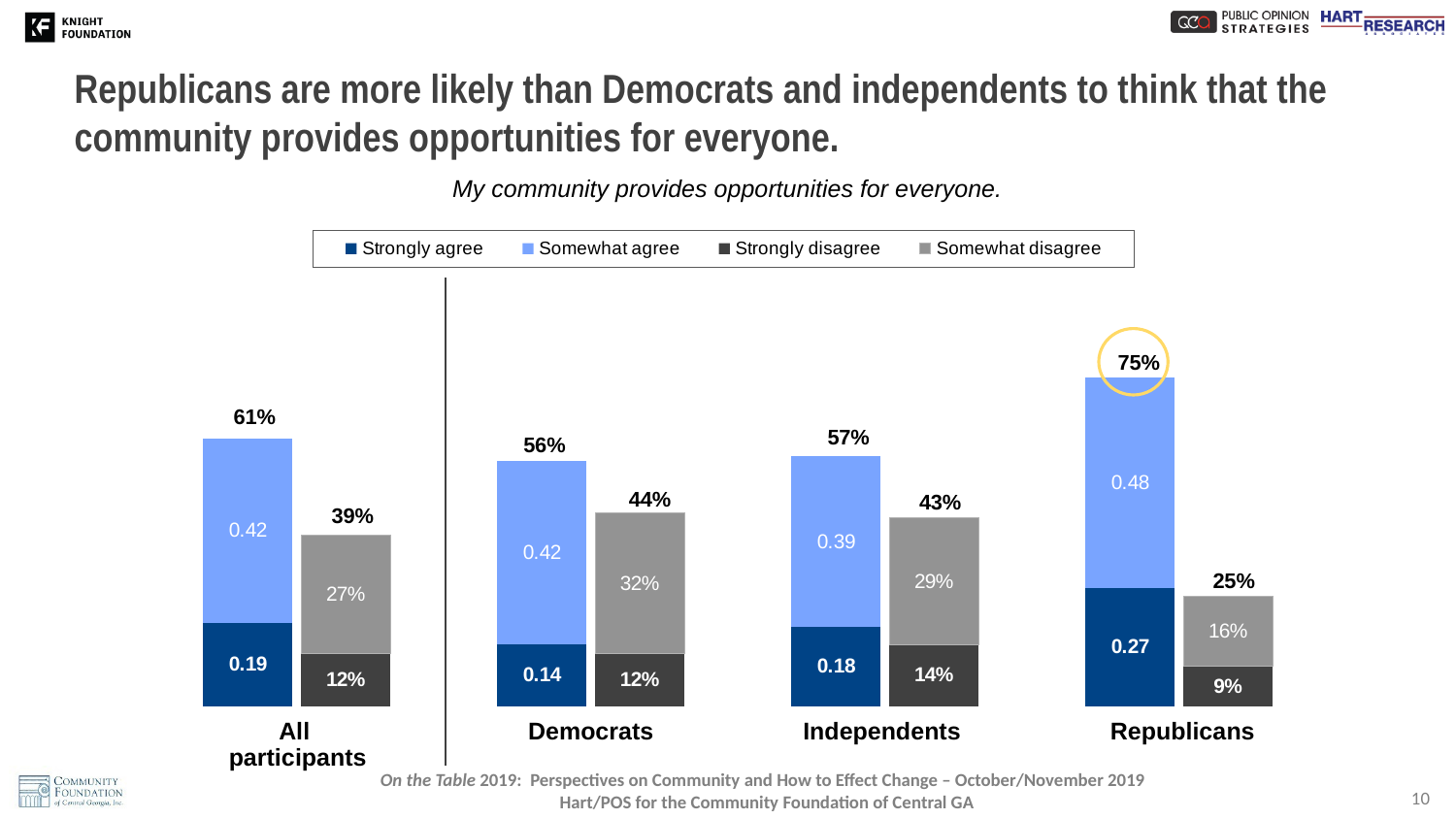
How many groups are shown along the x axis? 4 What is the Somewhat disagree value printed on the bar for Independents? 29% What is the Strongly disagree value printed on the bar for Republicans? 9% What is the difference between the total agree percentage for Republicans and for Democrats? 19% What kind of chart is shown on the slide? Stacked bar chart Which is larger, the Somewhat disagree value for Democrats or for Independents? Democrats What is the subtitle statement shown above the chart? My community provides opportunities for everyone. What is the total agree value shown above the agree bar for Republicans? 75% Which group has the highest total agree percentage? Republicans What is the Strongly agree value printed on the bar for Democrats? 0.14 How many series does the legend list? 4 Which group has the lowest total disagree percentage? Republicans